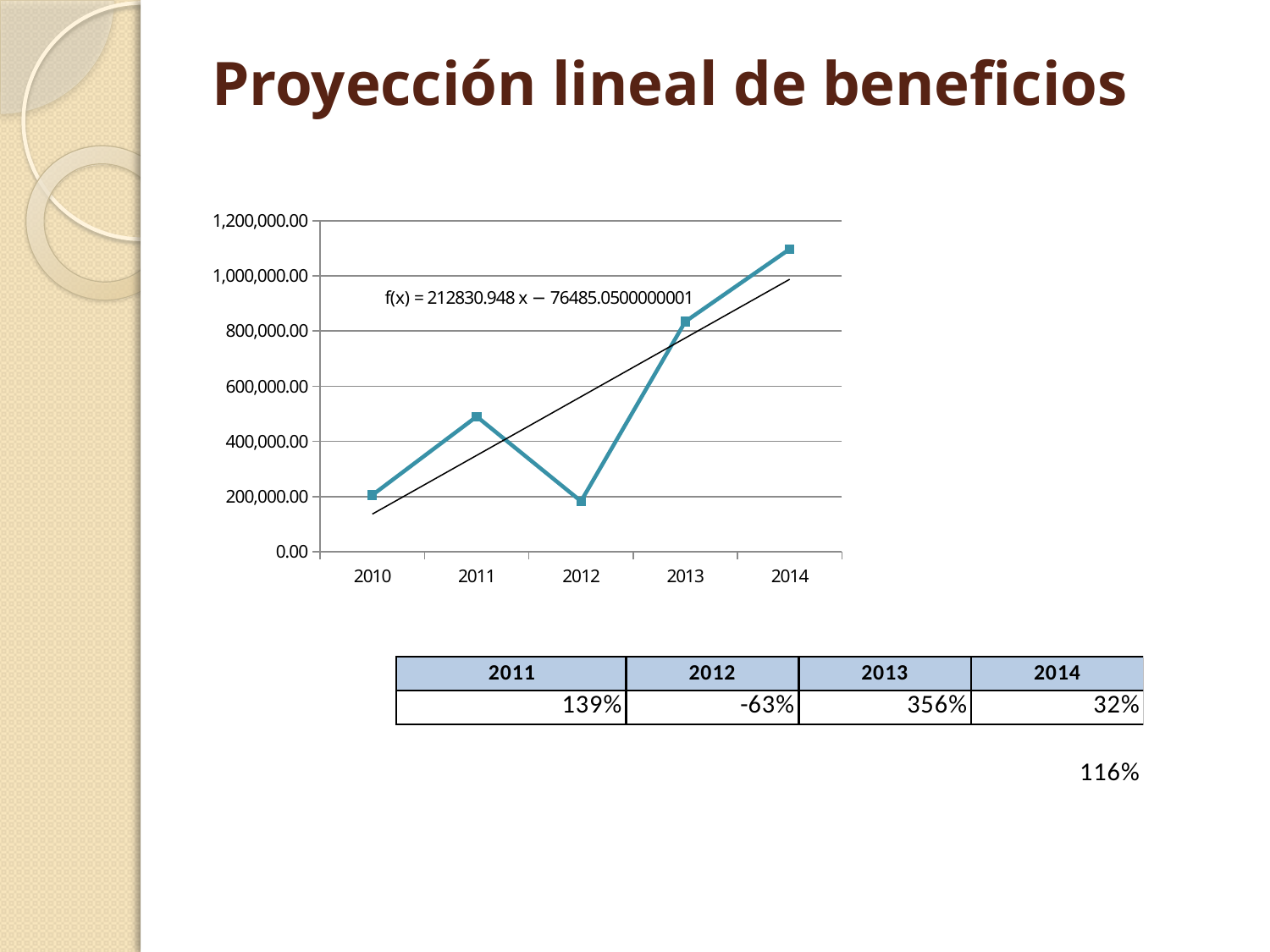
Is the value for 2013 greater or less than 600,000.00? greater Which year has the highest value in the chart? 2014 What is the first year shown on the x axis of the chart? 2010 Which year has the larger value, 2011 or 2013? 2013 Is the value for 2011 greater or less than 400,000.00? greater Is the value for 2014 greater or less than 1,000,000.00? greater What is the trendline equation printed on the chart? f(x) = 212830.948 x − 76485.0500000001 What kind of chart is shown on the slide? line chart How many years are plotted on the x axis of the chart? 5 Do the values rise or fall from 2012 to 2014? rise